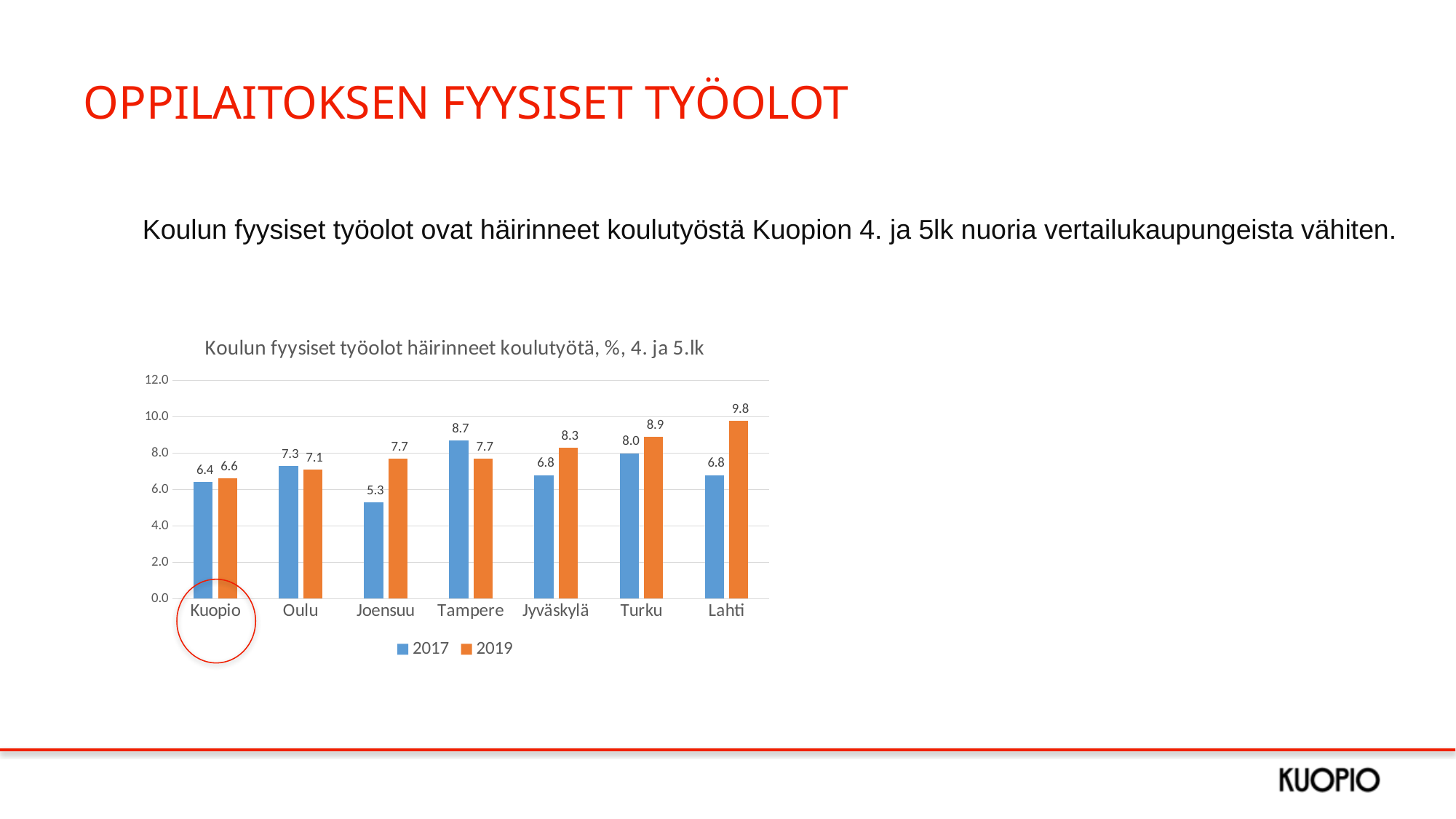
What is the 2017 value for Joensuu? 5.3 What kind of chart is shown on the slide? Bar chart Which city has the highest 2017 value? Tampere Which city has the lowest 2017 value? Joensuu How many cities are shown on the x axis? 7 What is the 2019 value for Kuopio? 6.6 What is the difference between the 2019 and 2017 values for Lahti? 3.0 Which city has the highest 2019 value? Lahti Which is larger for Tampere, the 2017 value or the 2019 value? 2017 What is the 2019 value for Lahti? 9.8 How many series does the legend list? 2 What is the title of the chart? Koulun fyysiset työolot häirinneet koulutyötä, %, 4. ja 5.lk